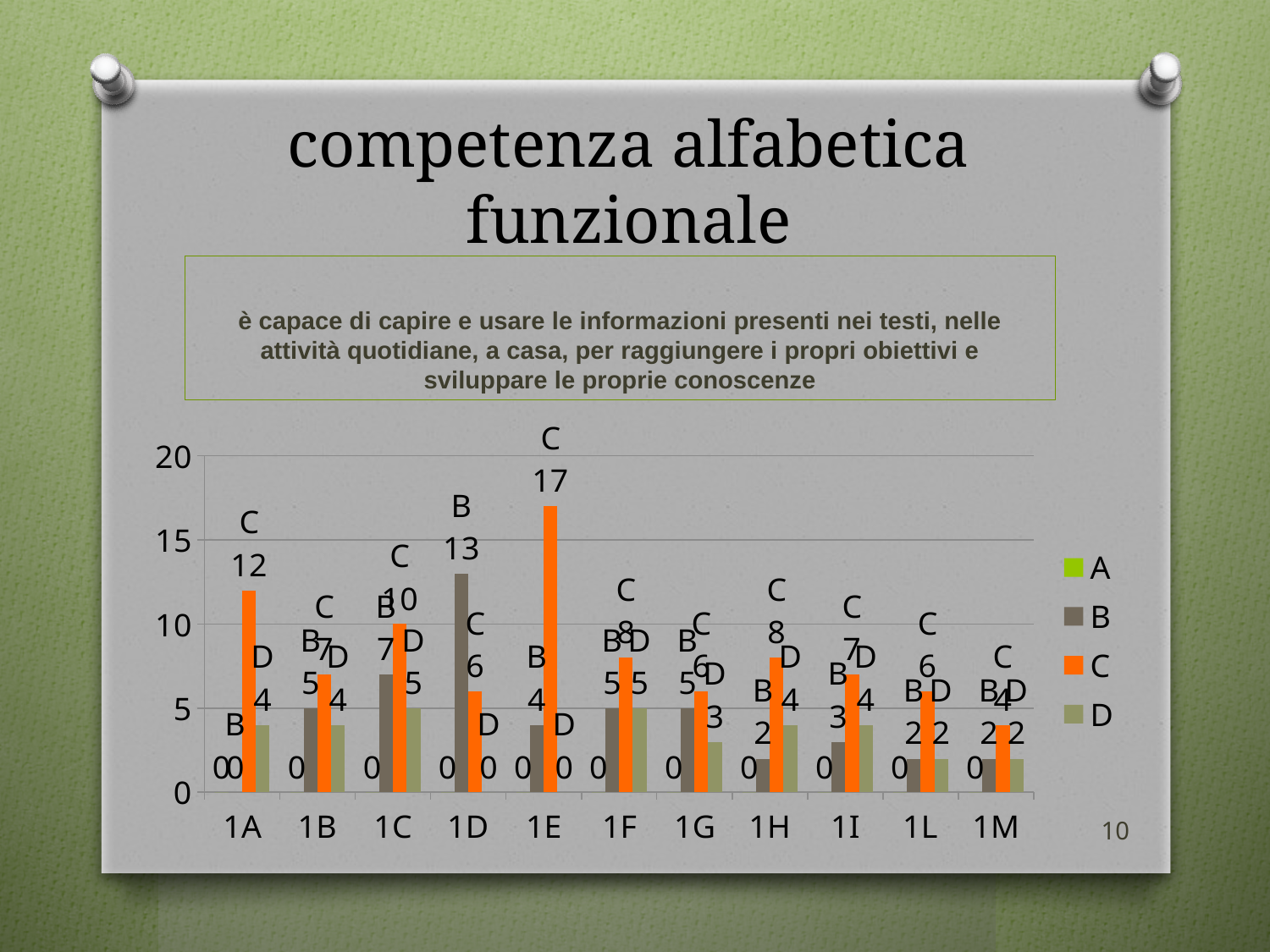
How many series does the legend list? 4 What is the value of series C for category 1A? 12 What is the difference between the C value and the B value for category 1E? 13 Which category has the highest value for series B? 1D How many categories are shown on the x axis? 11 Which category has the highest value for series C? 1E What kind of chart is shown on the slide? bar chart What is the value of series B for category 1D? 13 What is the value of series A for category 1H? 0 Which is larger for category 1C: the value of series B or series C? C What is the value of series D for category 1C? 5 What is the value of series C for category 1E? 17